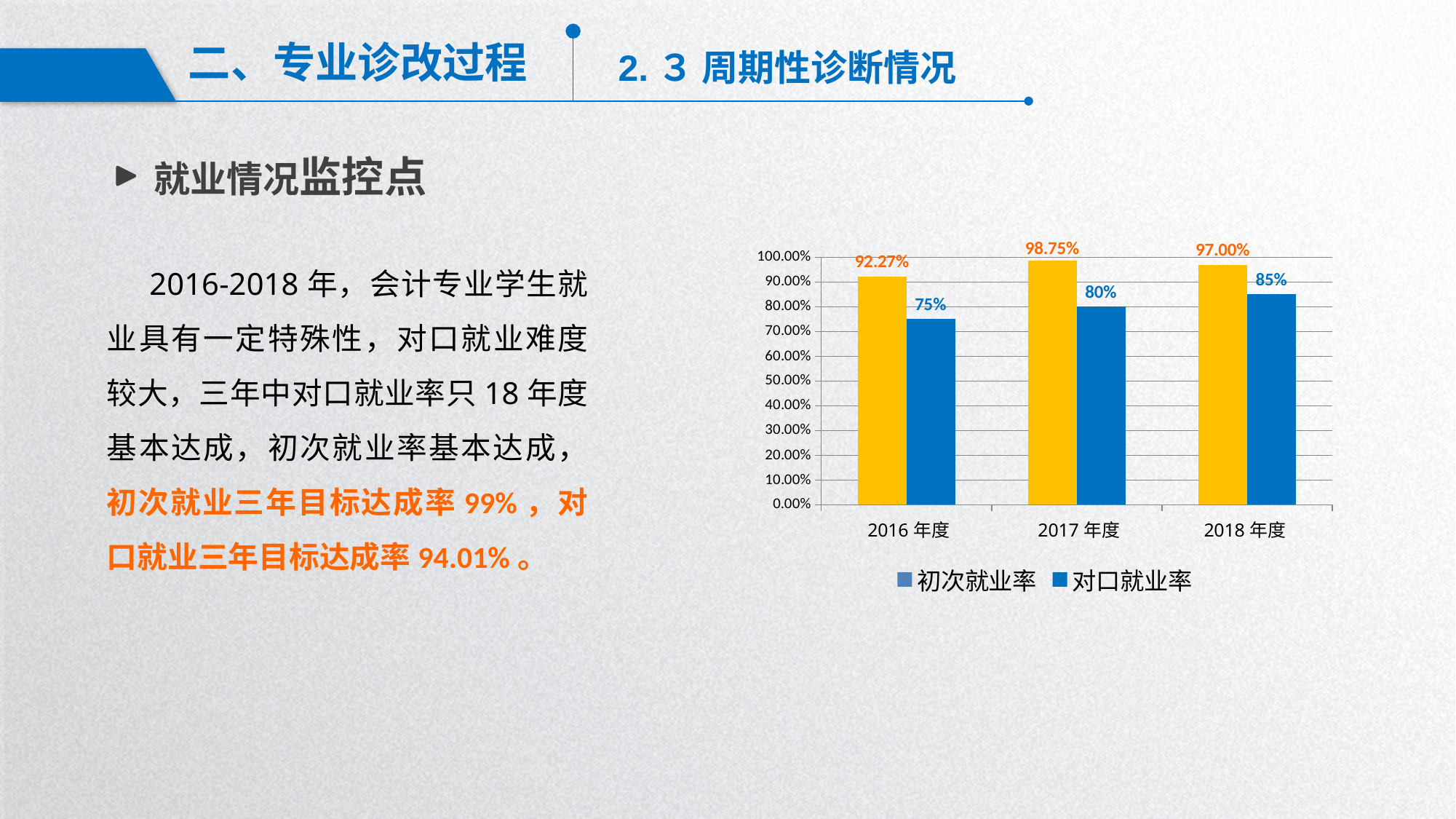
What is the 对口就业率 for 2018 年度? 85% What is the difference between the 对口就业率 in 2018 年度 and in 2016 年度? 10% How many series does the chart legend list? 2 What is the difference between the 初次就业率 in 2017 年度 and in 2016 年度? 6.48% Which is larger: the 初次就业率 in 2018 年度 or the 初次就业率 in 2016 年度? 2018 年度 Does the 对口就业率 rise or fall from 2016 年度 to 2018 年度? rise How many years are shown on the x axis of the chart? 3 Which year has the lowest 对口就业率? 2016 年度 What is the 对口就业率 for 2016 年度? 75% What is the 初次就业率 for 2017 年度? 98.75% What is the 初次就业率 for 2016 年度? 92.27% Which year has the highest 初次就业率? 2017 年度